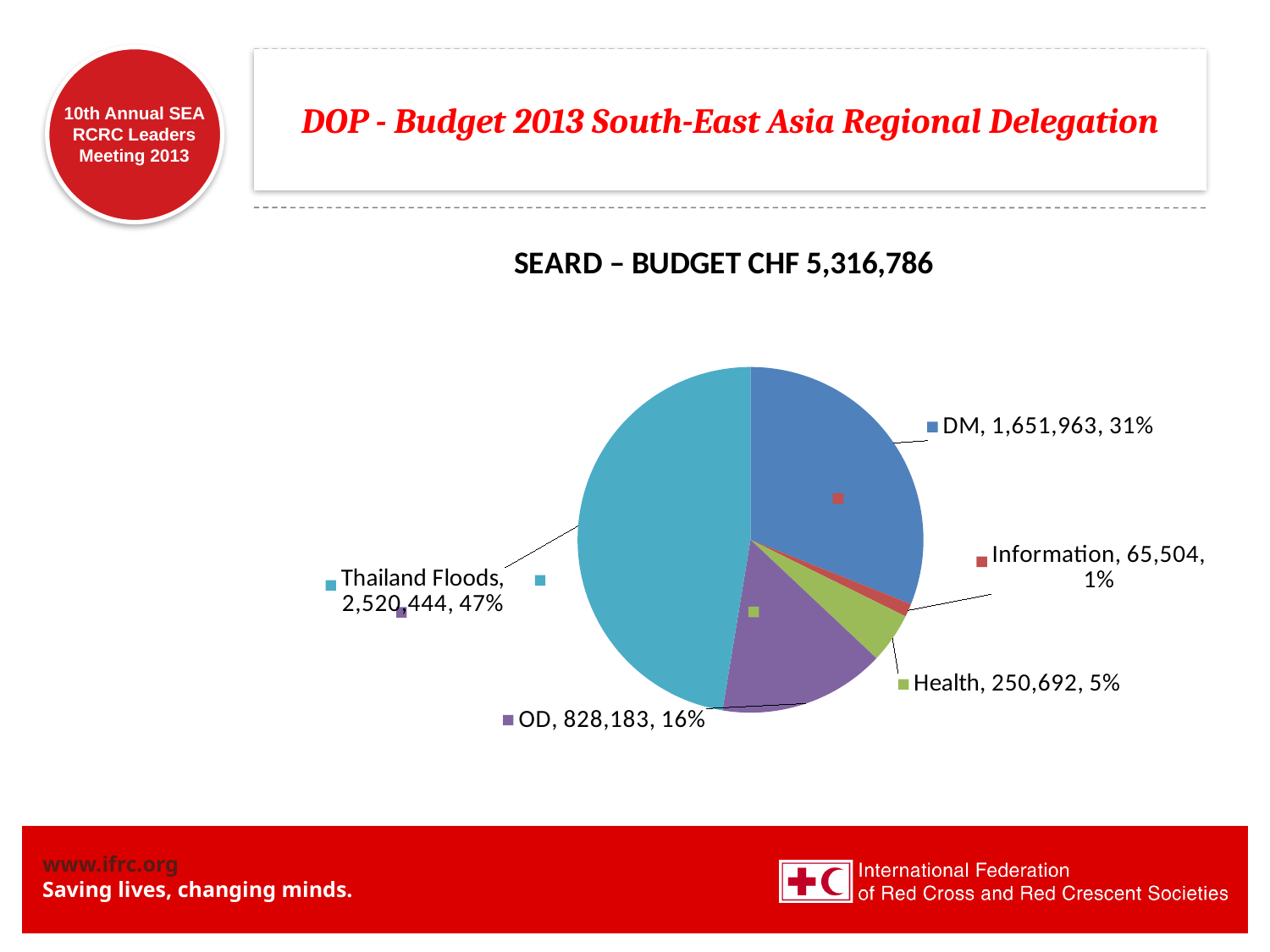
What is the value for Health in the pie chart? 250,692 Which category has the largest slice of the pie chart? Thailand Floods Which category has the smallest slice of the pie chart? Information How many categories are shown in the pie chart? 5 What is the value for Thailand Floods in the pie chart? 2,520,444 Which is larger, the value for OD or the value for Health? OD What share of the pie does Health represent? 5% What is the value for DM in the pie chart? 1,651,963 What type of chart is shown on the slide? pie chart What share of the pie does DM represent? 31% What is the value for Information in the pie chart? 65,504 What is the value for OD in the pie chart? 828,183